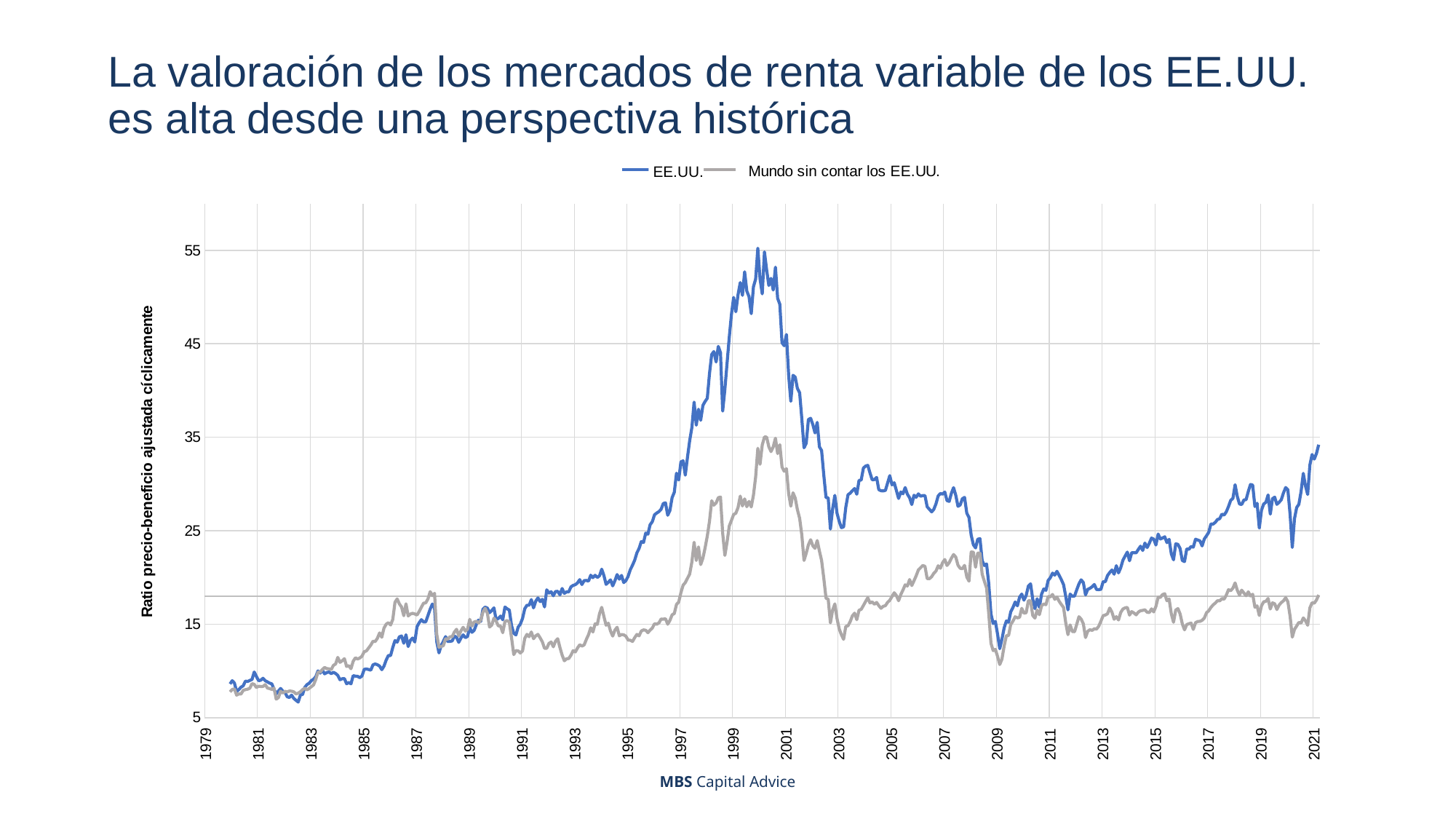
Is the lowest value of the EE.UU. series around 2009 greater or less than 25? less Which series reaches the highest value anywhere on the chart? EE.UU. Is the value of the Mundo sin contar los EE.UU. series in 2021 greater or less than 25? less How many series does the legend list? 2 What are the two series named in the legend? EE.UU. and Mundo sin contar los EE.UU. Is the peak value of the EE.UU. series around 2000 greater or less than 45? greater Does the EE.UU. series rise or fall between 1995 and 2000? rise What kind of chart is shown on the slide? line chart What is the label of the vertical axis? Ratio precio-beneficio ajustada cíclicamente Which series has the higher value in 2021, EE.UU. or Mundo sin contar los EE.UU.? EE.UU.